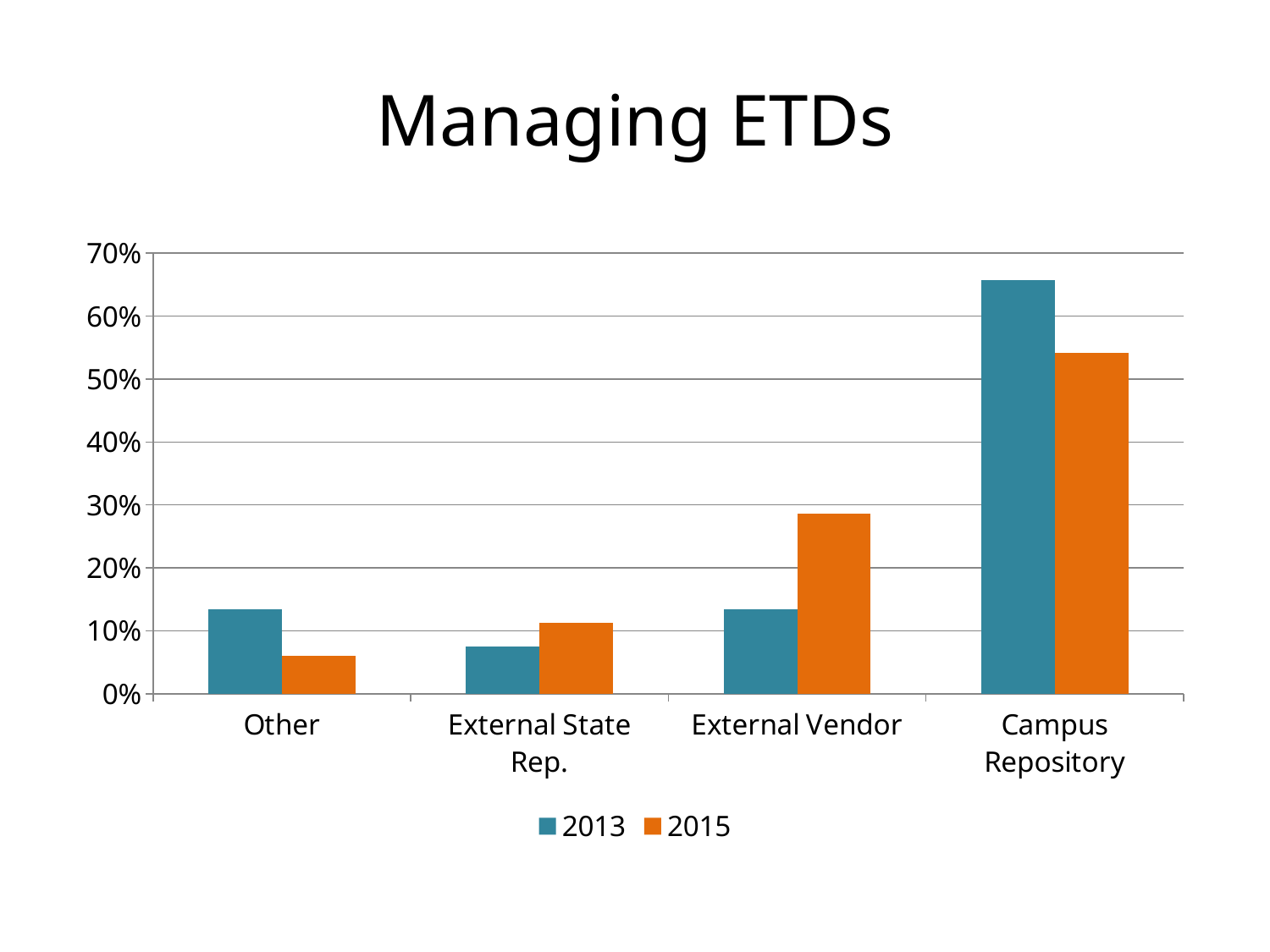
How many categories are shown on the x axis of the chart? 4 Which category has the lowest value for 2013? External State Rep. What kind of chart is shown on the slide? bar chart Which category has the highest value for 2013? Campus Repository Which category has the lowest value for 2015? Other For Campus Repository, which year has the larger value, 2013 or 2015? 2013 What is the title of the chart? Managing ETDs Is the 2015 value for Other greater or less than 10%? less Is the 2015 value for External Vendor greater or less than 30%? less How many series does the legend list? 2 Is the 2013 value for Campus Repository greater or less than 60%? greater For External Vendor, which year has the larger value, 2013 or 2015? 2015